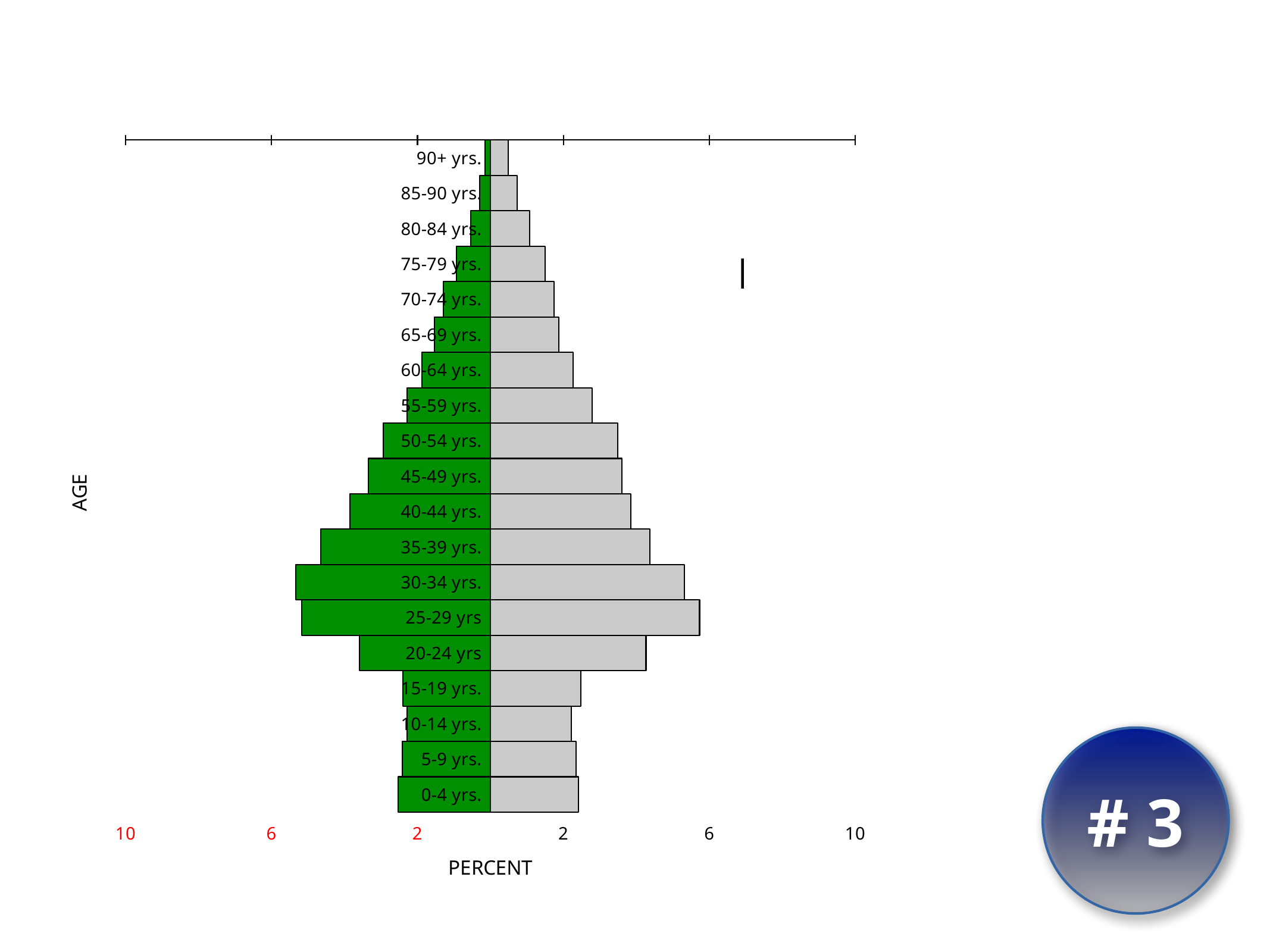
Is the grey bar value for 25-29 yrs greater or less than 6? less Is the grey bar value for 25-29 yrs greater or less than 2? greater Is the green bar value for 30-34 yrs. greater or less than 2? greater Which age group has the shortest grey bar on the right side? 90+ yrs. What is the label of the vertical axis? AGE How many age groups are shown on the chart? 19 Which age group has the longest grey bar on the right side? 25-29 yrs What kind of chart is shown on the slide? bar chart Which age group has the shortest green bar on the left side? 90+ yrs. What is the label of the horizontal axis? PERCENT Which has the longer grey bar, 25-29 yrs or 15-19 yrs.? 25-29 yrs